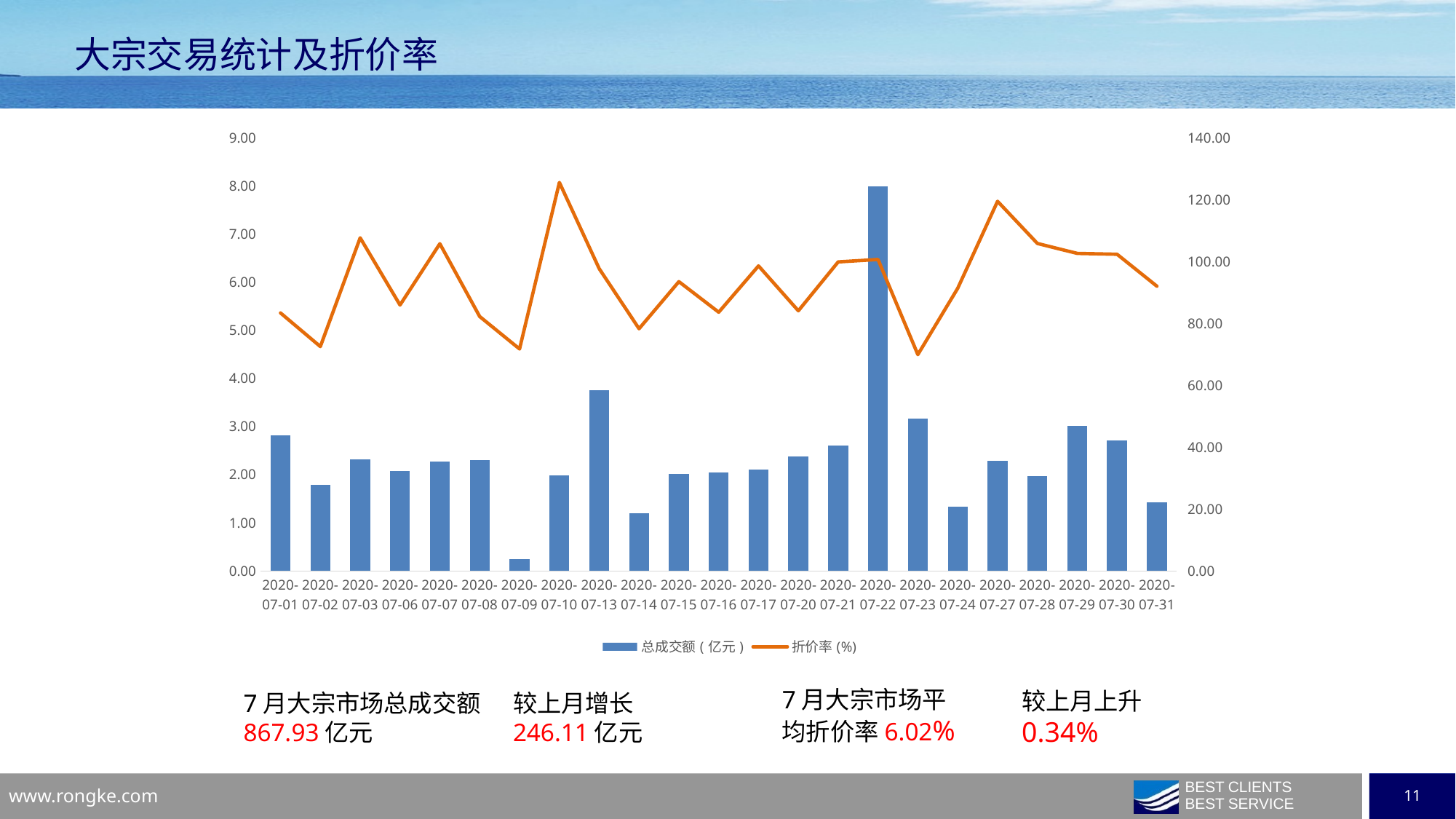
On which date does the 折价率 (%) line reach its highest point? 2020-07-10 What kind of chart is shown on the slide? A combined bar and line chart How many dates are shown along the x axis of the chart? 23 Which date has the larger 总成交额 bar, 2020-07-13 or 2020-07-23? 2020-07-13 Is the 总成交额 bar for 2020-07-22 greater or less than 7.00? greater Which date has the lowest bar for 总成交额 (亿元)? 2020-07-09 What are the two series named in the chart legend? 总成交额 (亿元) and 折价率 (%) Is the 折价率 (%) value for 2020-07-23 greater or less than 80.00? less How many series does the chart legend list? 2 Which date has the highest bar for 总成交额 (亿元)? 2020-07-22